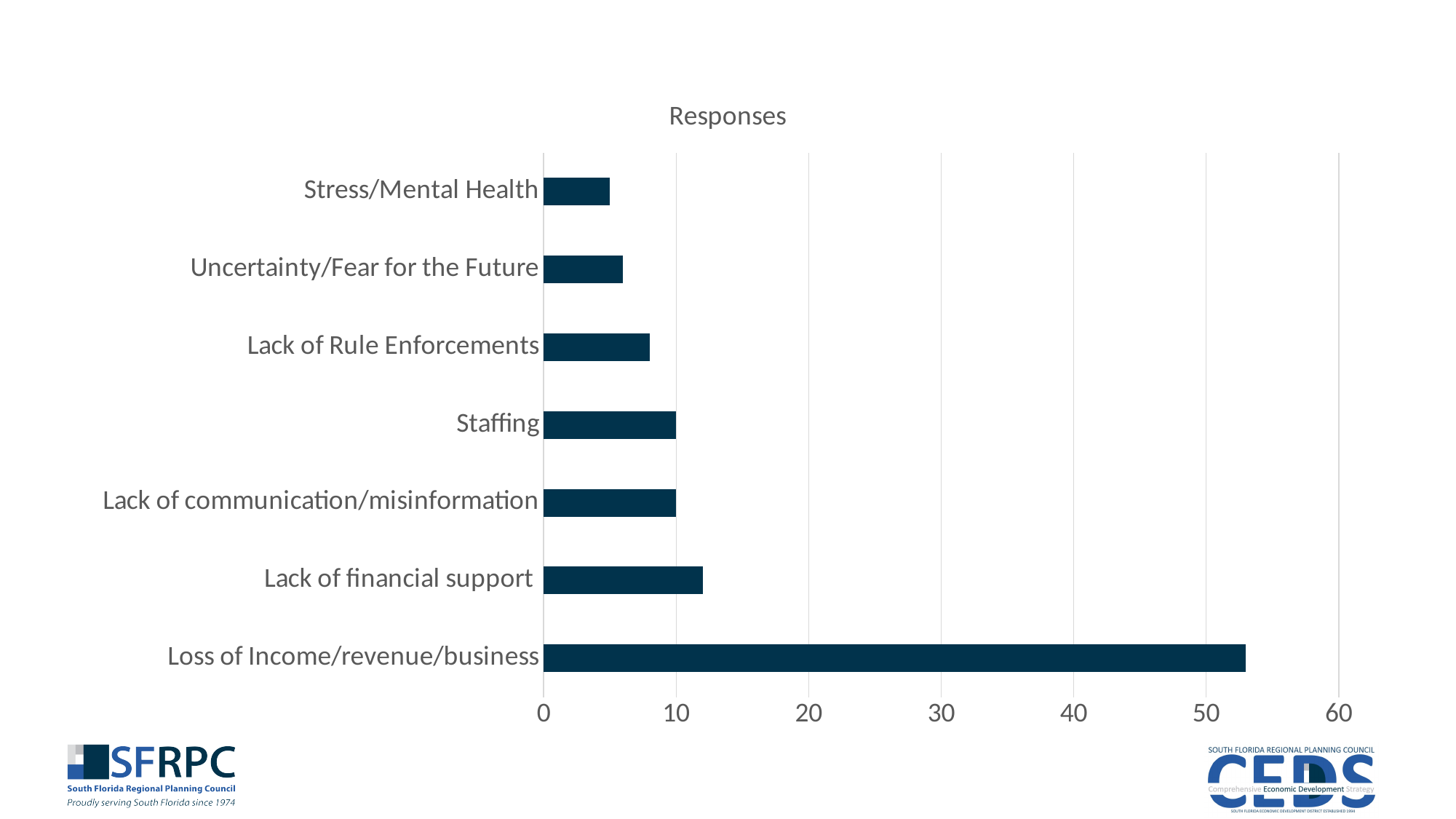
Is the value for Lack of financial support greater or less than 10? greater Which has more responses, Lack of Rule Enforcements or Stress/Mental Health? Lack of Rule Enforcements What is the value for Staffing? 10 Is the value for Lack of Rule Enforcements greater or less than 10? less How many categories are shown in the chart? 7 Which has more responses, Loss of Income/revenue/business or Lack of financial support? Loss of Income/revenue/business Is the value for Stress/Mental Health greater or less than 10? less What kind of chart is shown on the slide? bar chart Which category has the highest number of responses? Loss of Income/revenue/business What is the title of the chart? Responses